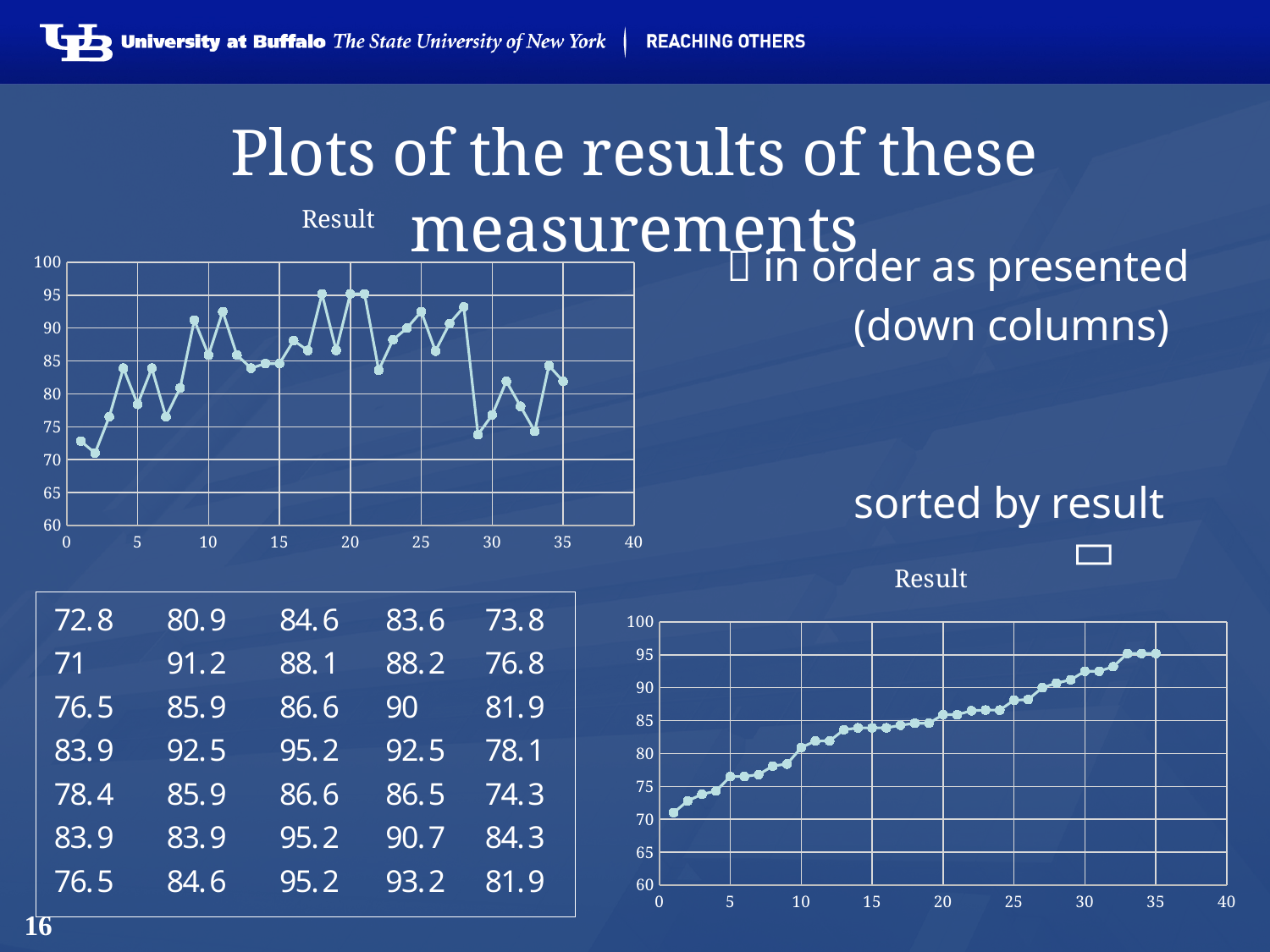
In the bottom-right chart (sorted by result), is the value at x = 1 greater or less than 75? less In the top-left chart (in order as presented), is the value at x = 20 greater or less than 90? greater In the bottom-right chart (sorted by result), do the values rise or fall along the x axis? rise How many data points are plotted in the top-left chart (in order as presented)? 35 In the top-left chart (in order as presented), is the value at x = 29 greater or less than 80? less What type of chart is the top-left chart titled "Result"? line chart How many data points are plotted in the bottom-right chart (sorted by result)? 35 What is the highest value shown on the y axis of the top-left chart? 100 What type of chart is the bottom-right chart titled "Result"? line chart In the bottom-right chart (sorted by result), at which x value is the lowest point plotted? 1